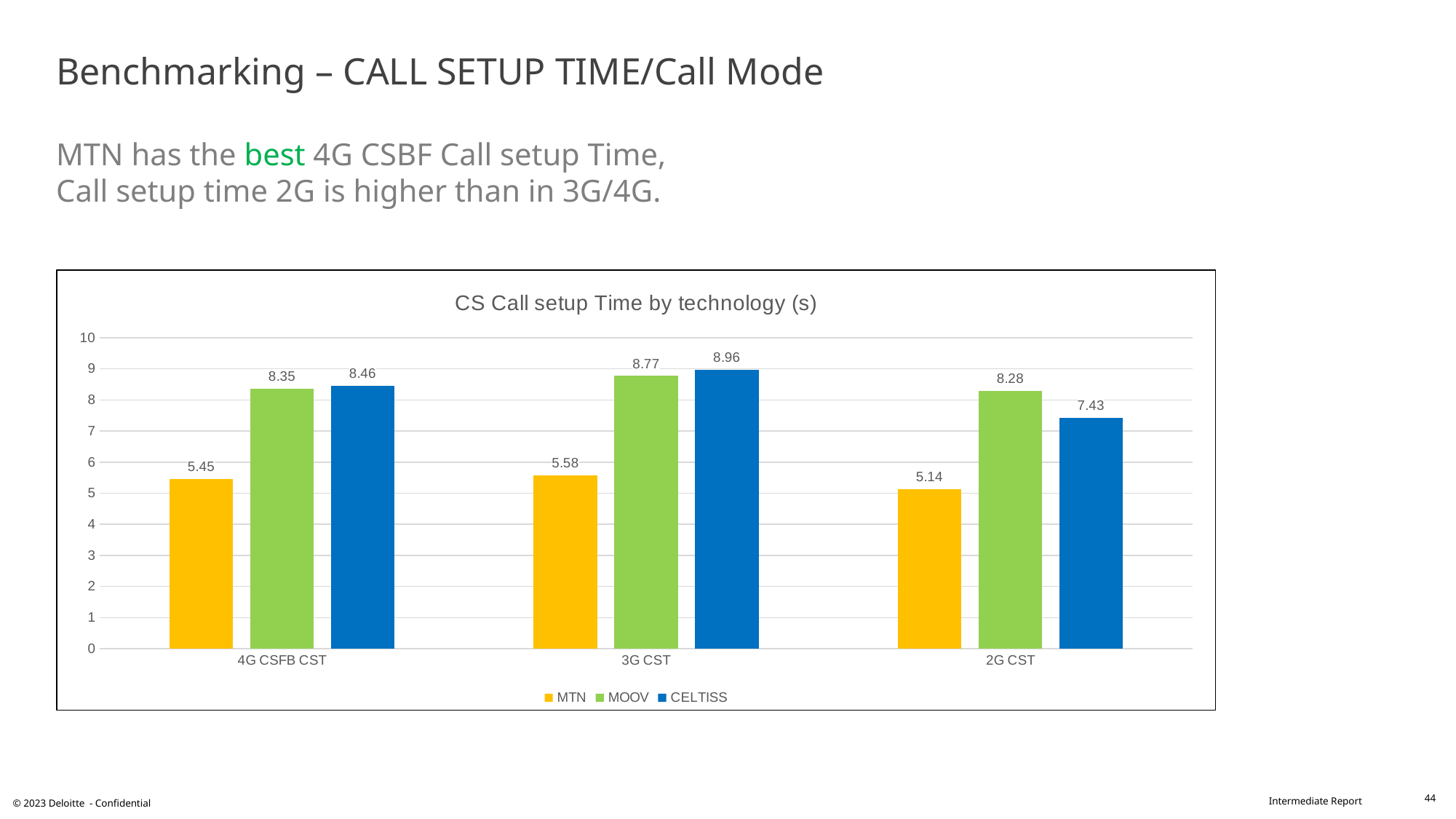
What is the value for CELTISS in the 3G CST category? 8.96 What is the title of the chart? CS Call setup Time by technology (s) Which operator has the highest call setup time in the 3G CST category? CELTISS How many series does the legend list? 3 How many categories are shown on the x axis? 3 Is the value for MOOV in the 3G CST category greater or less than 8? greater Which operator has the lowest call setup time in the 2G CST category? MTN What is the value for MOOV in the 2G CST category? 8.28 What is the difference between the CELTISS and MTN values in the 2G CST category? 2.29 What is the value for MTN in the 4G CSFB CST category? 5.45 What kind of chart is shown on the slide? Bar chart Which is larger in the 2G CST category, MOOV or CELTISS? MOOV